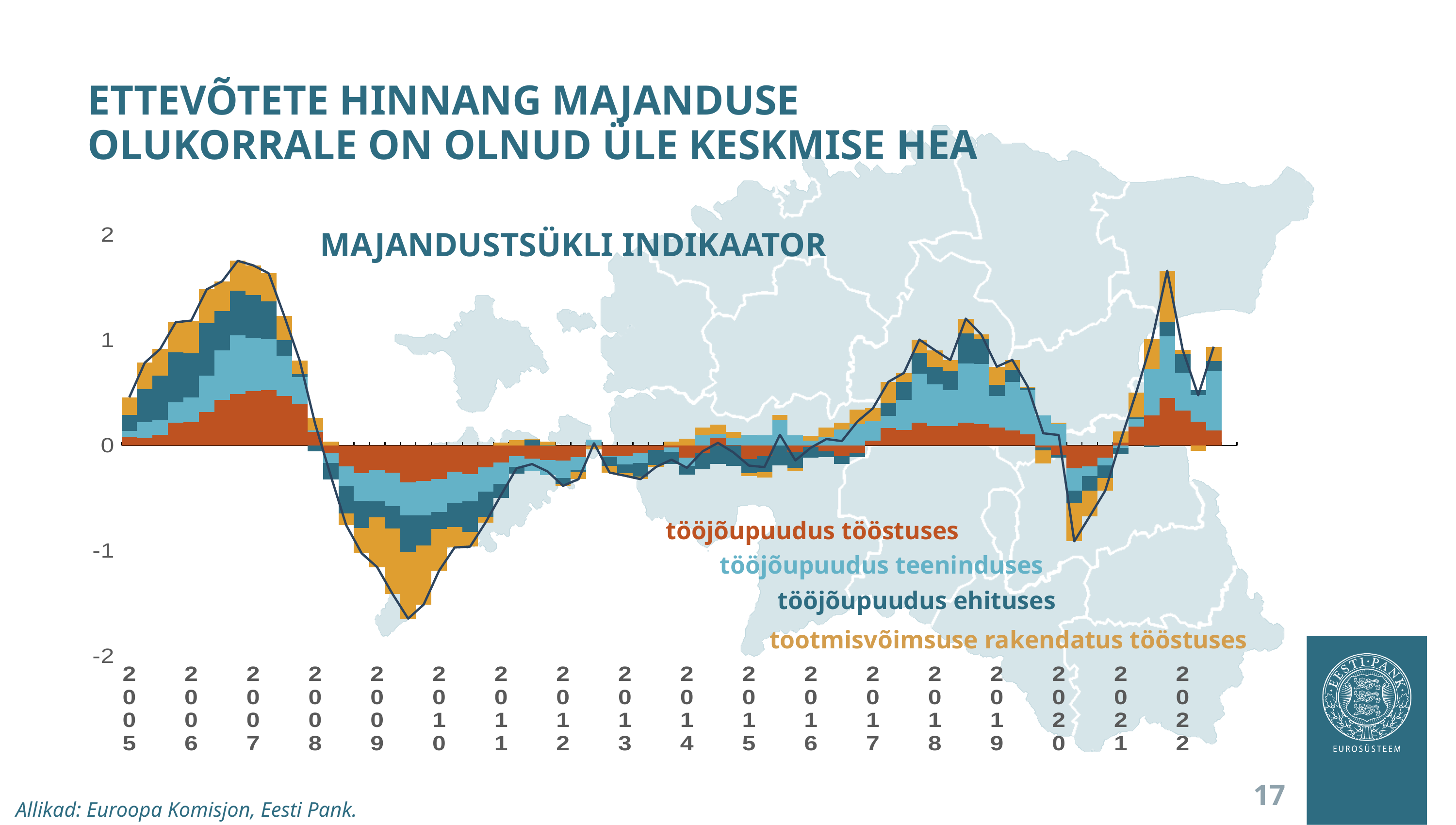
Is the peak of the line in 2021 greater or less than 1? greater Does the line rise or fall between 2009 and 2011? rise Does the line rise or fall between 2007 and 2009? fall How many year labels are shown on the x axis? 18 Is the lowest point of the line in 2009 greater or less than -1? less Is the lowest point of the line in 2020 greater or less than 0? less Which year is the first label on the x axis? 2005 What kind of chart is shown on the slide? Stacked bar chart with a line How many series does the chart's legend list? 4 What is the title of the chart? MAJANDUSTSÜKLI INDIKAATOR Which series is shown in orange-red at the bottom of the stacked bars? tööjõupuudus tööstuses